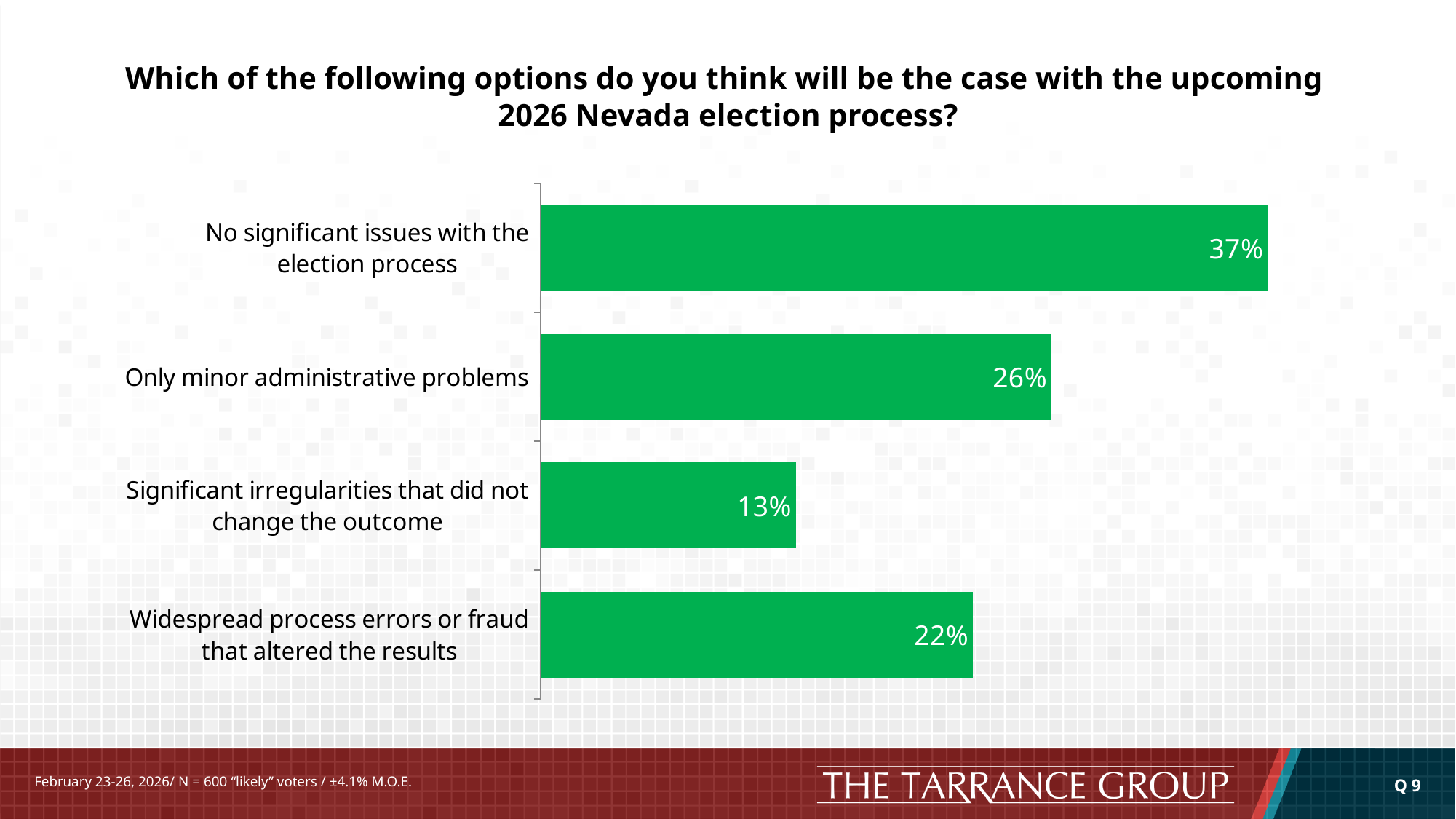
What colour are the bars in the chart? Green Which option has the highest percentage? No significant issues with the election process What value is shown for "Widespread process errors or fraud that altered the results"? 22% What percentage of respondents chose "No significant issues with the election process"? 37% Which option has the lowest percentage? Significant irregularities that did not change the outcome What type of chart is shown on the slide? Bar chart What is the difference between the percentages for "No significant issues with the election process" and "Only minor administrative problems"? 11% Which is larger: the value for "Only minor administrative problems" or for "Widespread process errors or fraud that altered the results"? Only minor administrative problems What percentage is shown for "Significant irregularities that did not change the outcome"? 13% How many response options are shown in the chart? 4 What is the difference between "Widespread process errors or fraud that altered the results" and "Significant irregularities that did not change the outcome"? 9% What value is shown for "Only minor administrative problems"? 26%